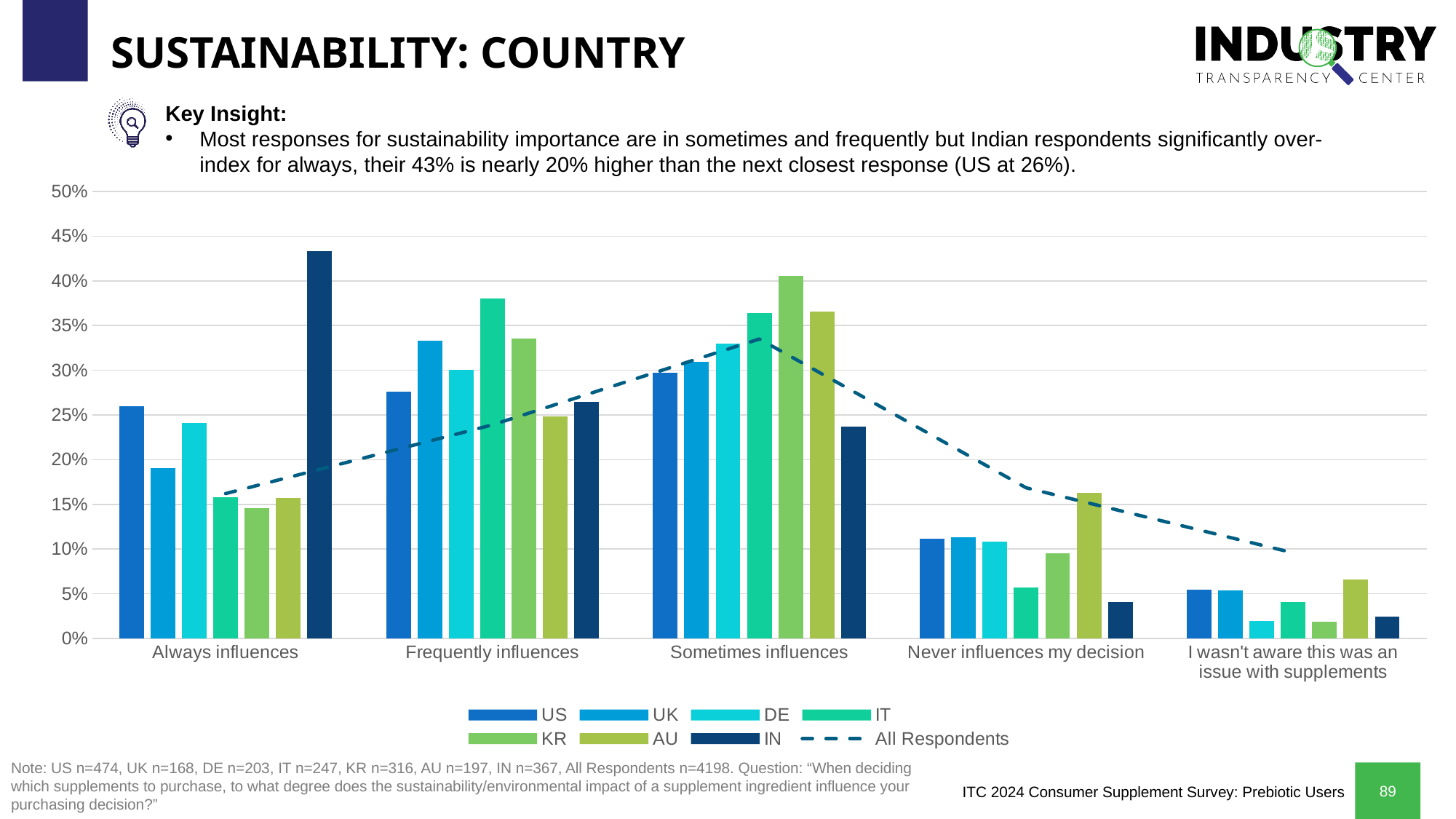
Which series is drawn as a dashed line rather than bars? All Respondents Is the value for IN under 'Always influences' greater or less than 40%? greater Which country has the highest bar for 'Never influences my decision'? AU Which country has the highest bar for 'Sometimes influences'? KR Which country has the lowest bar for 'Sometimes influences'? IN Is the value for IN under 'Never influences my decision' greater or less than 5%? less Which country has the highest bar for 'Frequently influences'? IT How many response categories are shown along the x axis? 5 How many series does the legend list? 8 What kind of chart is shown on the slide? combination bar and line chart Which is larger for IN: 'Always influences' or 'Sometimes influences'? Always influences